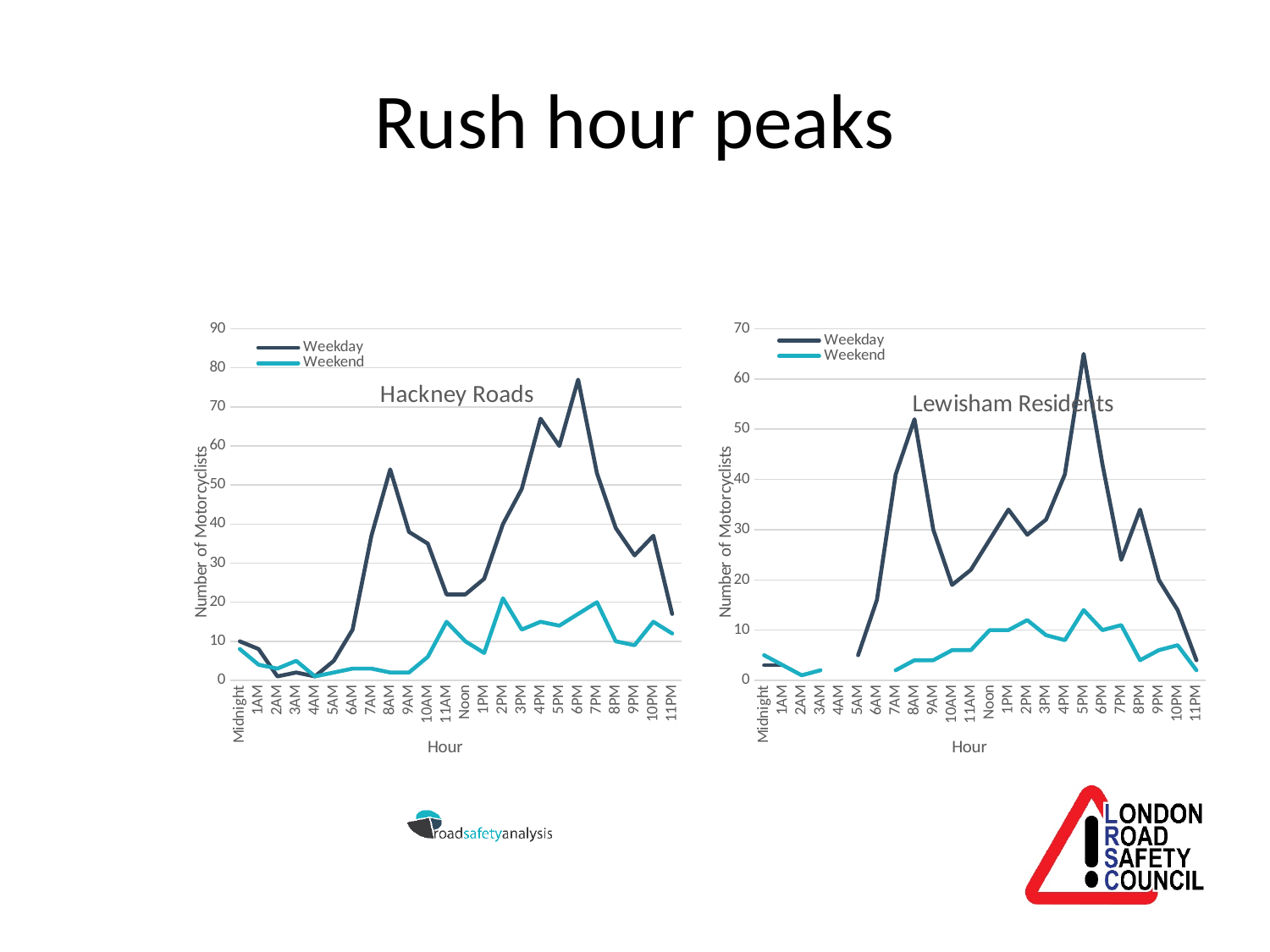
In the Hackney Roads chart, which is larger: the Weekday value at 6PM or the Weekday value at 8AM? 6PM In the Lewisham Residents chart, is the Weekday value at 5PM greater or less than 60? greater How many hour categories are shown on the x axis of the Hackney Roads chart? 24 How many series does the legend of the Lewisham Residents chart list? 2 In the Lewisham Residents chart, at which hour does the Weekday series reach its highest value? 5PM In the Hackney Roads chart, at which hour does the Weekday series reach its highest value? 6PM In the Hackney Roads chart, does the Weekday series rise or fall between 8AM and 11AM? fall What is the y-axis label on the Lewisham Residents chart? Number of Motorcyclists In the Hackney Roads chart, is the Weekday value at 6PM greater or less than 70? greater In the Lewisham Residents chart, which series is higher at 5PM, Weekday or Weekend? Weekday What type of chart is the Hackney Roads chart? line chart In the Hackney Roads chart, is the Weekend value at 11AM greater or less than 10? greater